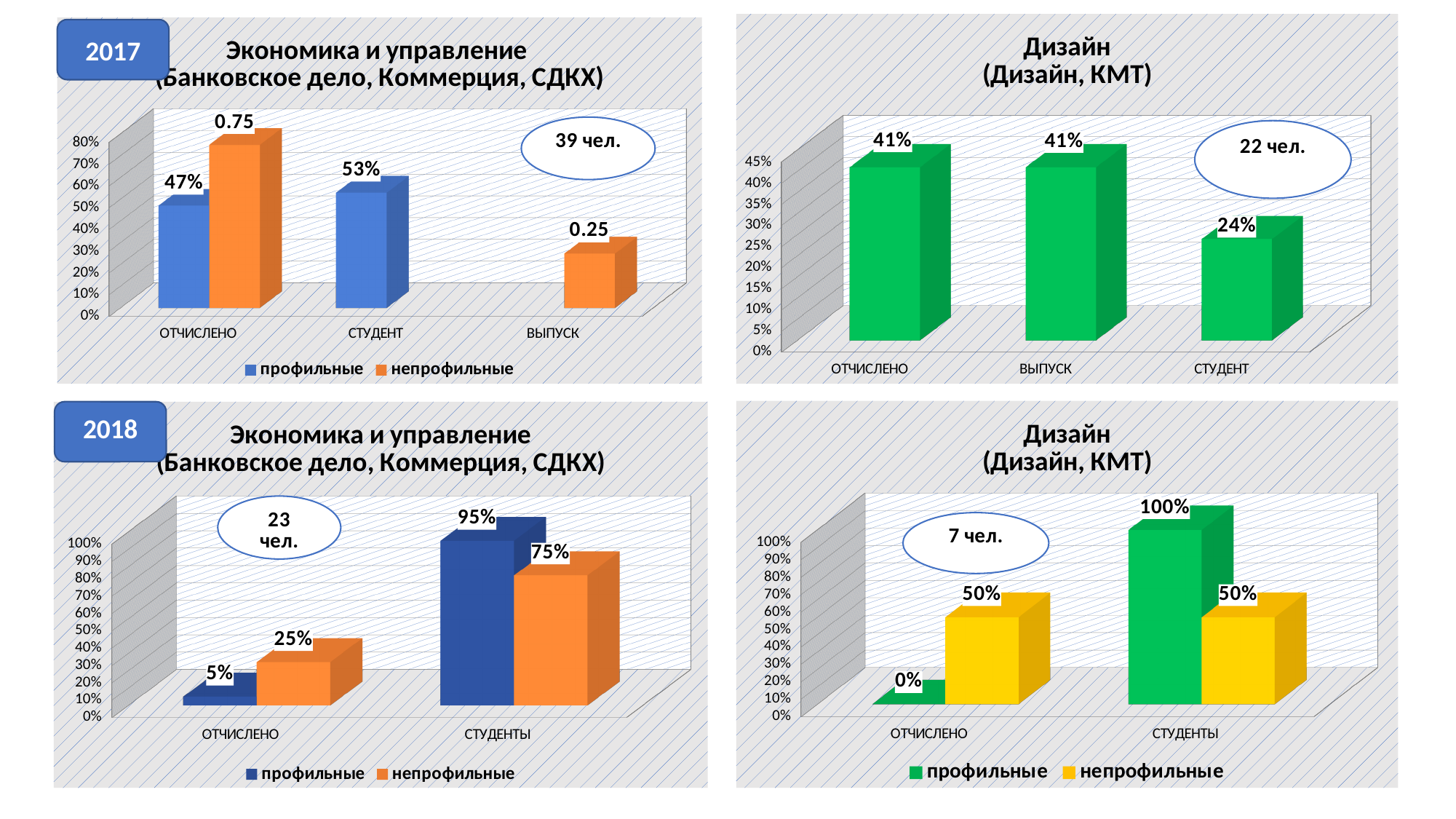
In the bottom-left chart (2018, Экономика и управление), what is the value for непрофильные in the СТУДЕНТЫ category? 75% In the top-right chart (2017, Дизайн), how many categories are shown on the x axis? 3 In the bottom-right chart (2018, Дизайн), what is the value for профильные in the ОТЧИСЛЕНО category? 0% In the bottom-left chart (2018, Экономика и управление), which is larger in the СТУДЕНТЫ category: профильные or непрофильные? профильные In the top-right chart (2017, Дизайн), what is the value for СТУДЕНТ? 24% In the top-right chart (2017, Дизайн), which category has the lowest value? СТУДЕНТ What kind of chart is the bottom-right chart (2018, Дизайн)? Bar chart In the bottom-right chart (2018, Дизайн), how many series does the legend list? 2 In the top-left chart (2017, Экономика и управление), what is the value for профильные in the СТУДЕНТ category? 53% In the top-left chart (2017, Экономика и управление), what is the value for непрофильные in the ВЫПУСК category? 0.25 In the top-left chart (2017, Экономика и управление), what is the value for профильные in the ОТЧИСЛЕНО category? 47% In the bottom-left chart (2018, Экономика и управление), what is the difference between профильные and непрофильные in the ОТЧИСЛЕНО category? 20%